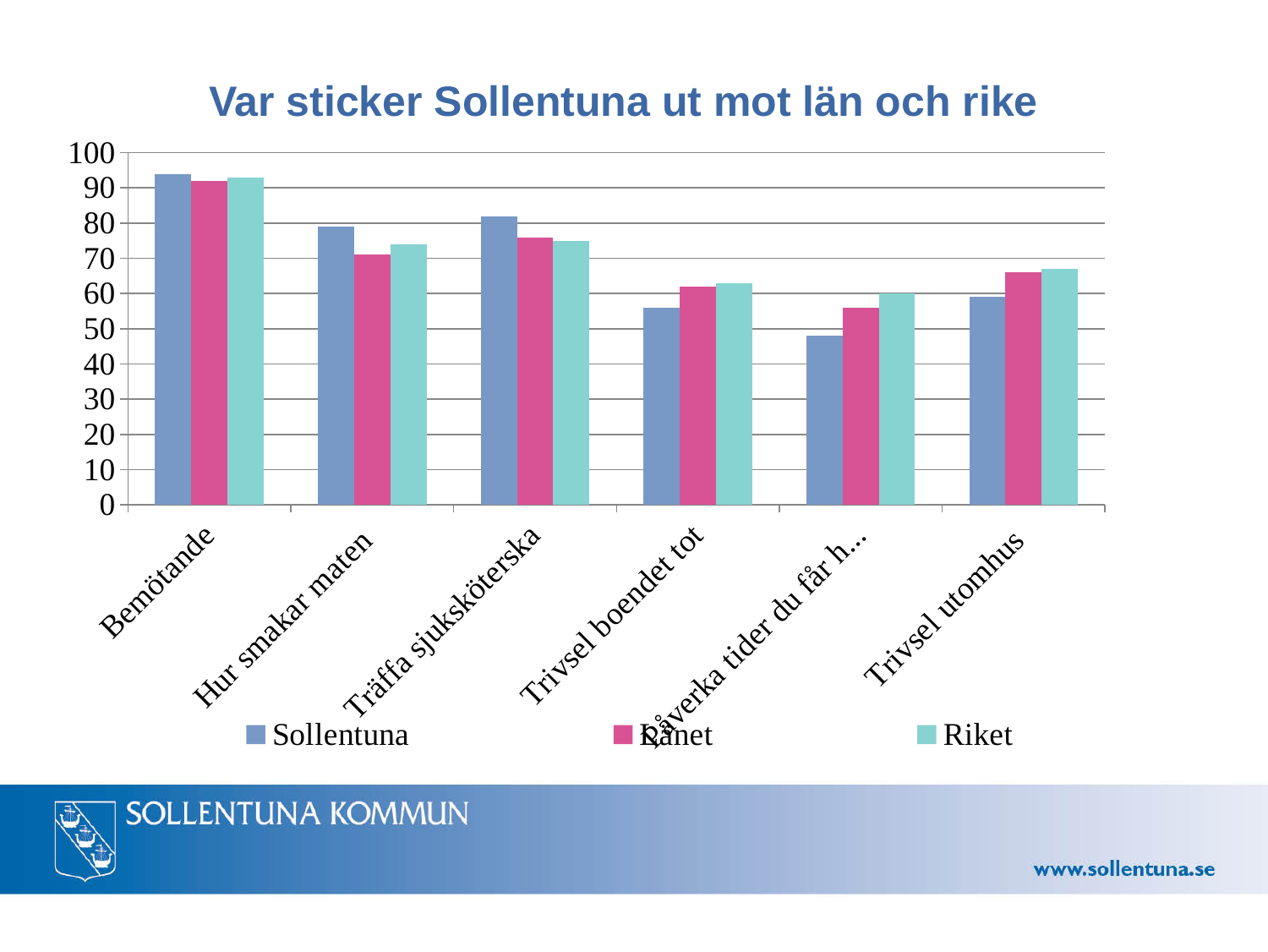
What kind of chart is shown on the slide? bar chart Is the Sollentuna value for Hur smakar maten greater or less than 70? greater How many categories are shown on the x axis? 6 Which category has the highest value for Sollentuna? Bemötande What is the title of the chart? Var sticker Sollentuna ut mot län och rike How many series does the legend list? 3 For Träffa sjuksköterska, which is larger: the Sollentuna value or the Länet value? Sollentuna Is the Sollentuna value for Påverka tider du får h... greater or less than 50? less Which series is shown in pink? Länet Which category has the lowest value for Sollentuna? Påverka tider du får h... Is the Riket value for Trivsel boendet tot greater or less than 60? greater For Trivsel utomhus, which is larger: the Sollentuna value or the Riket value? Riket